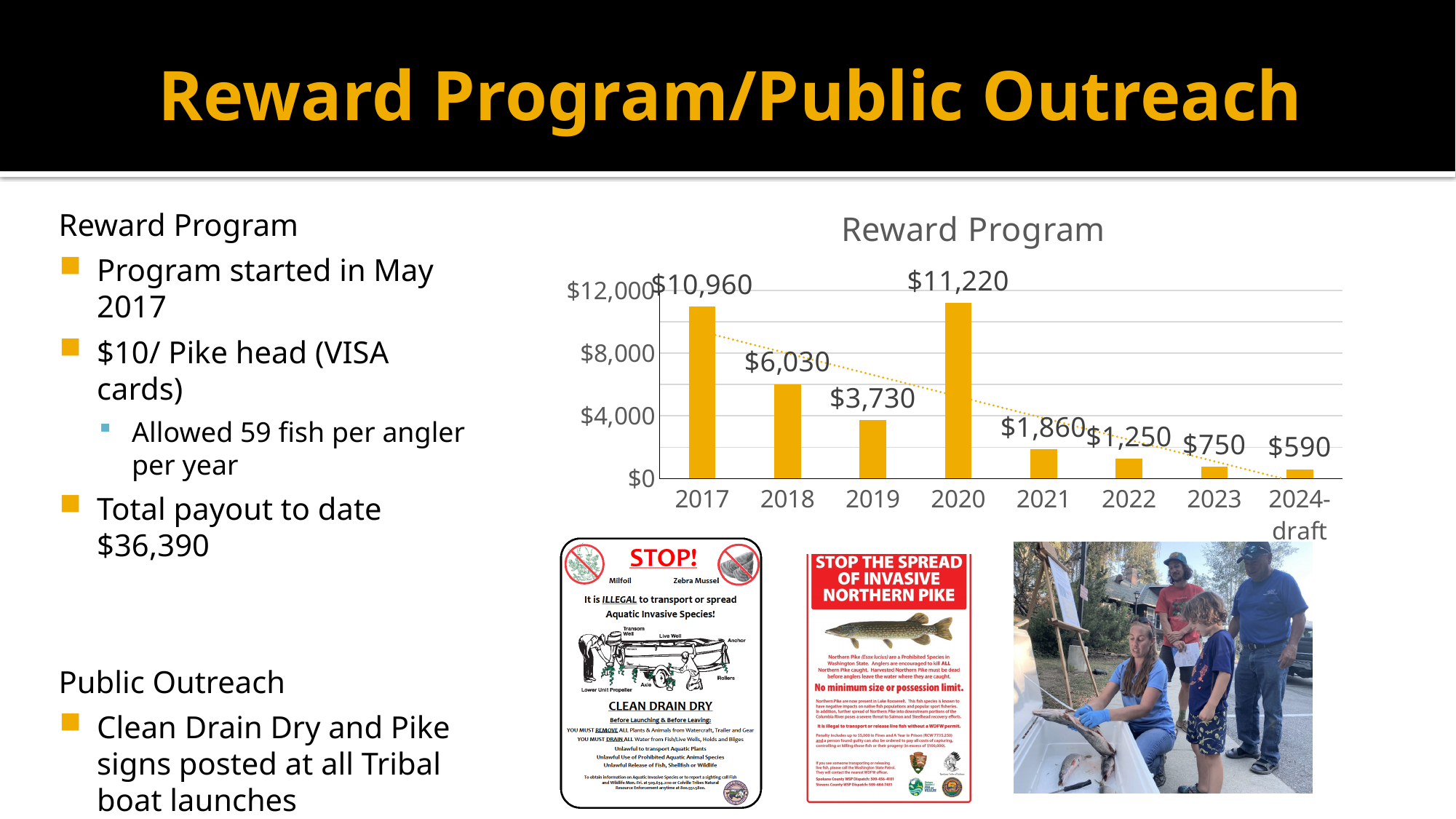
What is the title of the chart on the slide? Reward Program Which year has the highest value in the Reward Program chart? 2020 What is the value for 2020 in the Reward Program chart? $11,220 What is the difference between the 2018 and 2019 values in the Reward Program chart? $2,300 What is the value for 2024-draft in the Reward Program chart? $590 What kind of chart is the Reward Program chart? bar chart How many years are shown on the x axis of the Reward Program chart? 8 Is the value for 2018 in the Reward Program chart greater or less than $4,000? greater Which year has the lowest value in the Reward Program chart? 2024-draft Which is larger in the Reward Program chart, the value for 2021 or the value for 2022? 2021 What is the value for 2019 in the Reward Program chart? $3,730 What is the difference between the 2020 and 2017 values in the Reward Program chart? $260